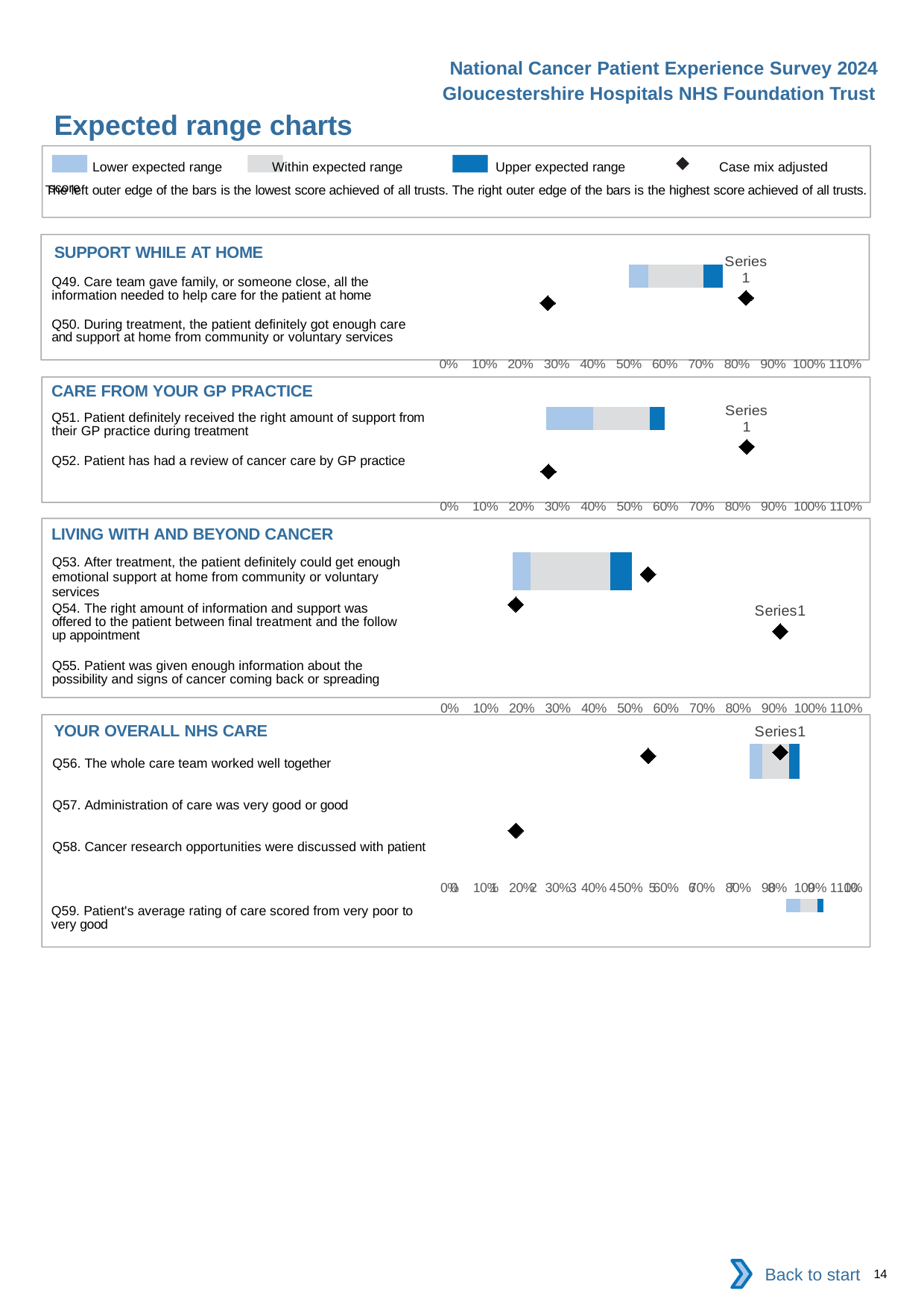
In the YOUR OVERALL NHS CARE chart, is the left edge of the upper expected range bar greater or less than 70%? greater How many questions are listed in the SUPPORT WHILE AT HOME chart? 2 How many entries does the legend at the top of the slide list? 4 What is the highest value shown on the x axis of the CARE FROM YOUR GP PRACTICE chart? 110% How many questions are listed in the LIVING WITH AND BEYOND CANCER chart? 3 How many questions are listed in the CARE FROM YOUR GP PRACTICE chart? 2 What kind of chart is used in the SUPPORT WHILE AT HOME section? bar chart In the CARE FROM YOUR GP PRACTICE chart, is the right edge of the expected range bar greater or less than 80%? less According to the legend, what marker shape represents the case mix adjusted score? diamond In the SUPPORT WHILE AT HOME chart, is the left edge of the expected range bar greater or less than 40%? greater